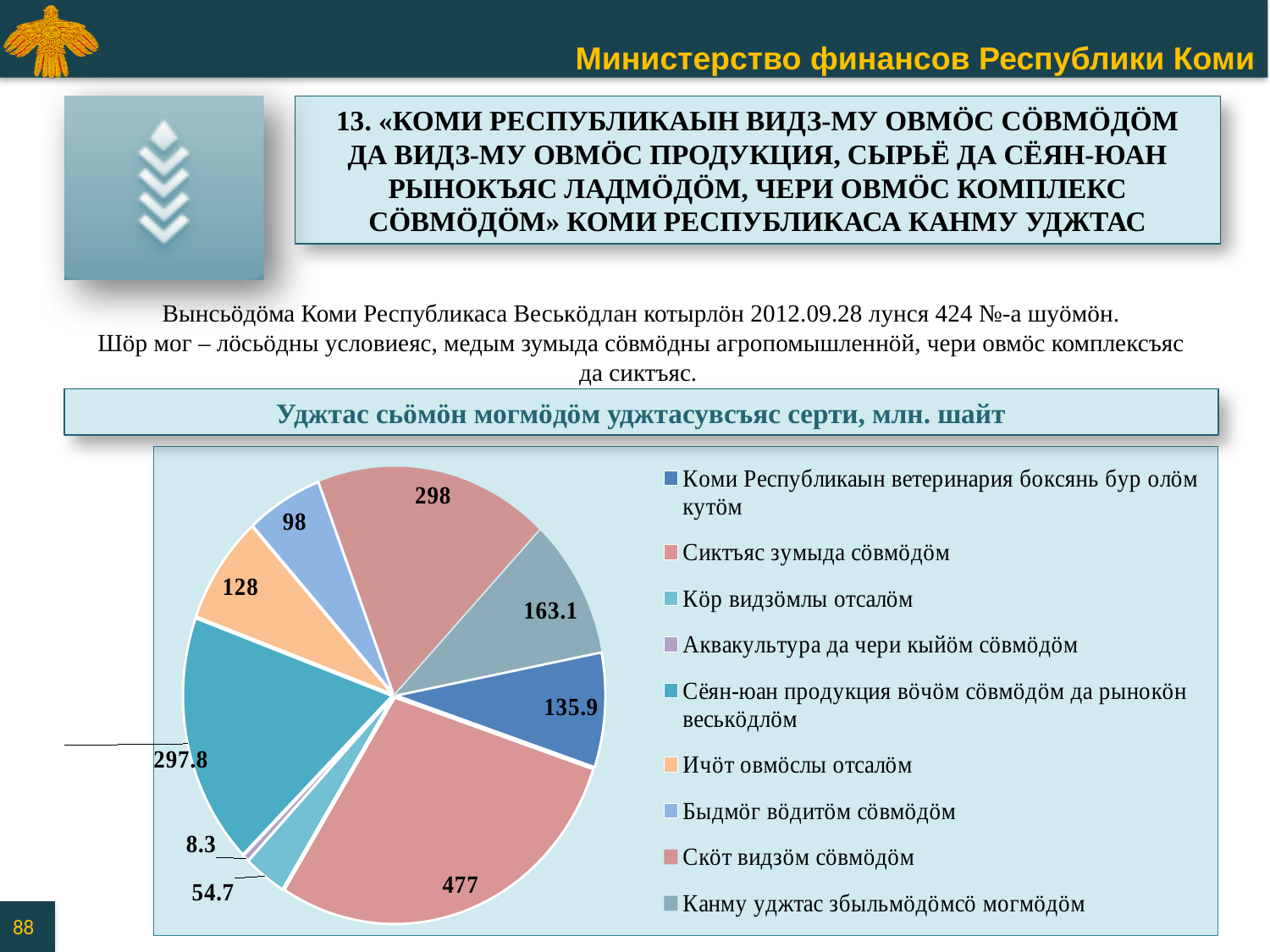
What is the value for "Аквакультура да чери кыйӧм сӧвмӧдӧм" in the pie chart? 8.3 How many entries does the legend of the pie chart list? 9 Which is larger: the value for "Ичӧт овмӧслы отсалӧм" or the value for "Быдмӧг вӧдитӧм сӧвмӧдӧм"? Ичӧт овмӧслы отсалӧм Which category has the largest slice in the pie chart? Сиктъяс зумыда сӧвмӧдӧм How many slices does the pie chart have? 9 What is the value for "Сиктъяс зумыда сӧвмӧдӧм" in the pie chart? 477 What kind of chart is shown on the slide? pie chart What is the title of the pie chart? Уджтас сьӧмӧн могмӧдӧм уджтасувсъяс серти, млн. шайт What is the value for "Коми Республикаын ветеринария боксянь бур олӧм кутӧм" in the pie chart? 135.9 What is the difference between the values for "Сиктъяс зумыда сӧвмӧдӧм" and "Сёян-юан продукция вӧчӧм сӧвмӧдӧм да рынокӧн веськӧдлӧм"? 179.2 What is the value for "Канму уджтас збыльмӧдӧмсӧ могмӧдӧм" in the pie chart? 163.1 Which category has the smallest slice in the pie chart? Аквакультура да чери кыйӧм сӧвмӧдӧм